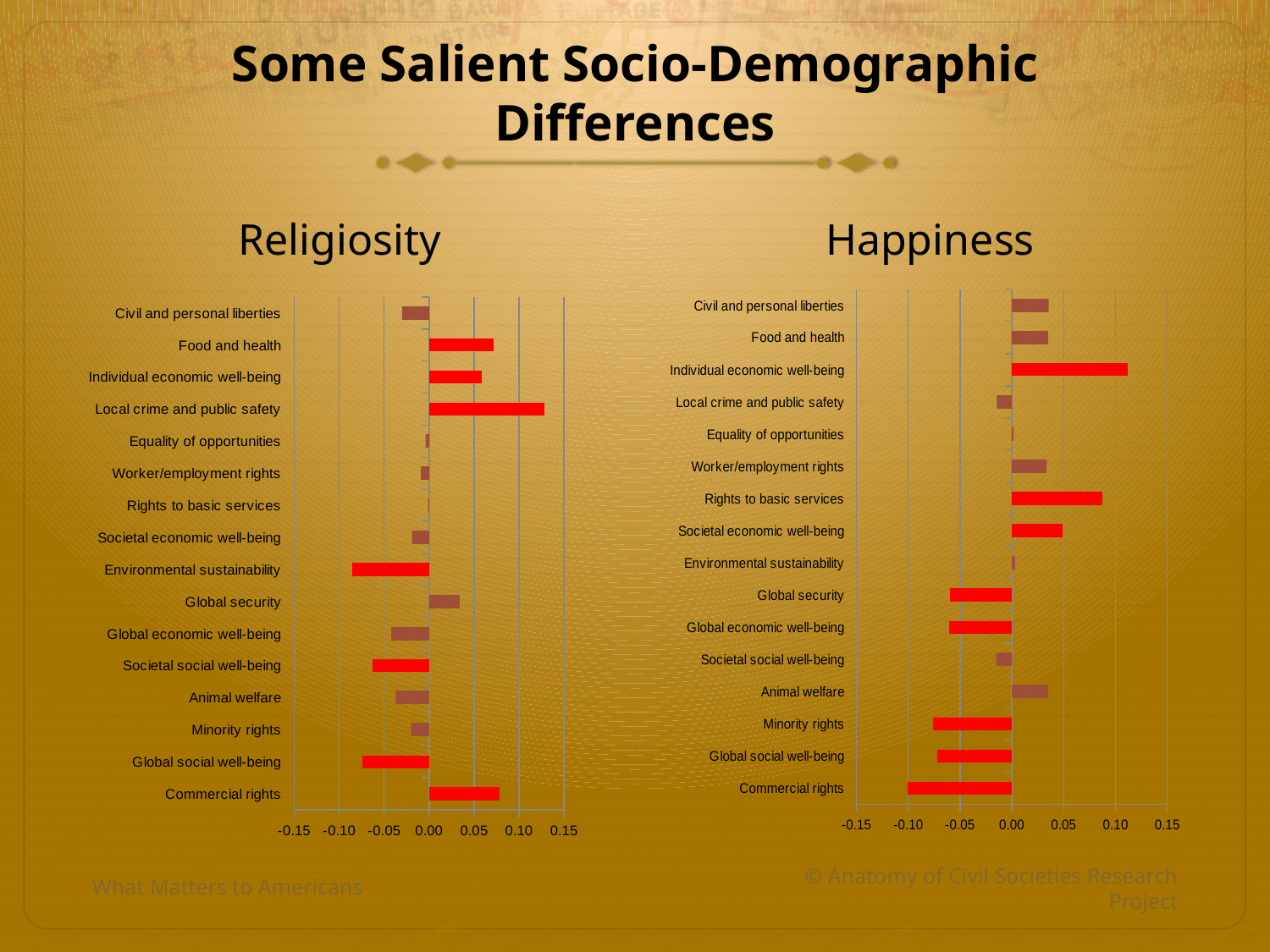
In the Happiness chart, which has the larger value: Global security or Commercial rights? Global security What are the titles of the two charts on the slide? Religiosity and Happiness In the Religiosity chart, which has the larger value: Local crime and public safety or Food and health? Local crime and public safety In the Happiness chart, is the value for Commercial rights greater or less than -0.05? less How many categories are plotted in the Happiness chart? 16 What kind of chart is the Religiosity chart? bar chart In the Religiosity chart, is the value for Local crime and public safety greater or less than 0.10? greater In the Happiness chart, which category has the lowest value? Commercial rights In the Religiosity chart, which category has the highest value? Local crime and public safety In the Religiosity chart, is the value for Food and health greater or less than 0.05? greater In the Happiness chart, which category has the highest value? Individual economic well-being